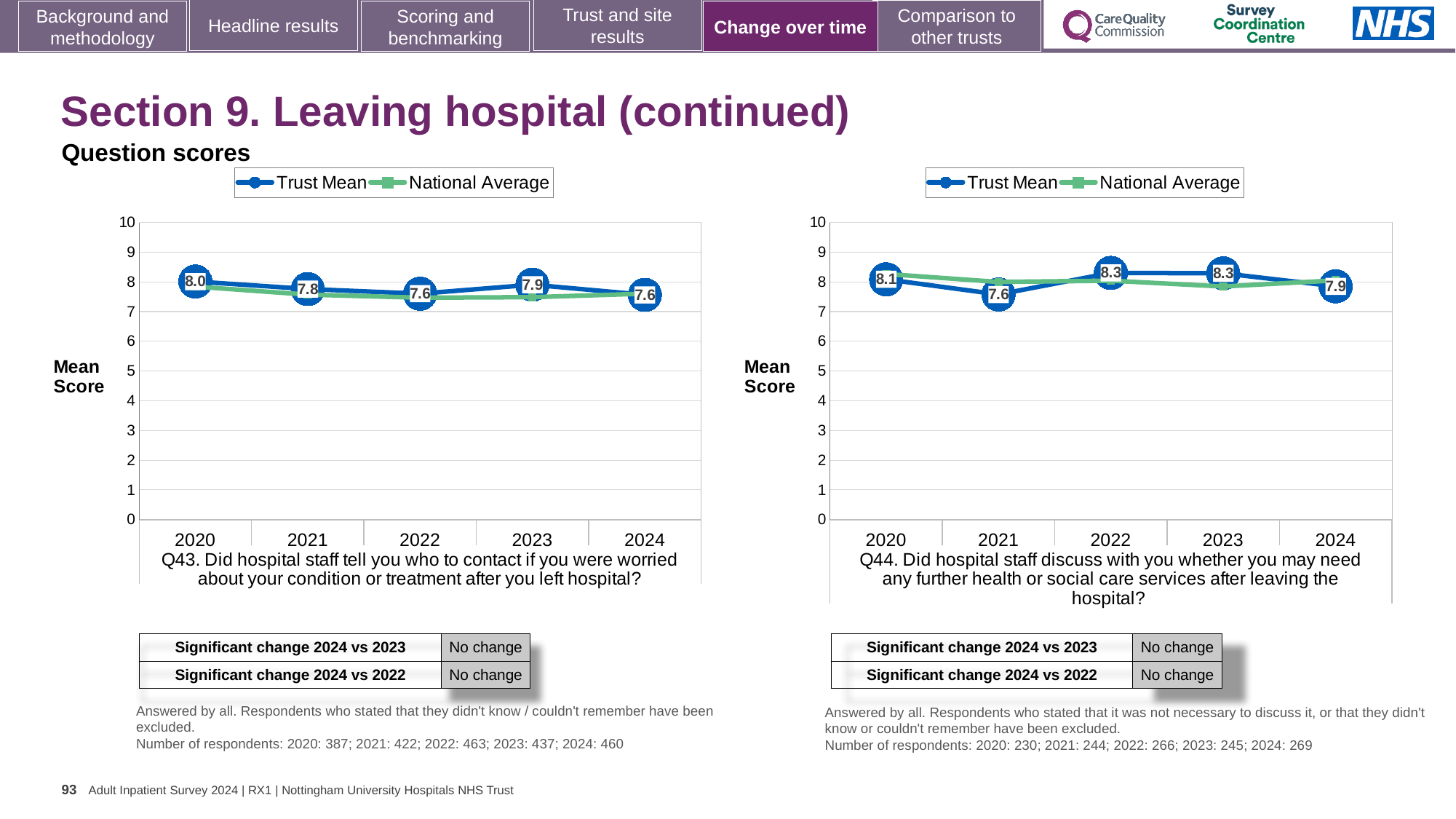
In the Q43 chart on the left, which year has the highest Trust Mean score? 2020 In the Q44 chart on the right, what is the difference between the Trust Mean scores for 2022 and 2021? 0.7 In the Q44 chart on the right, which year has the lowest Trust Mean score? 2021 In the Q44 chart on the right, what is the Trust Mean score for 2021? 7.6 What kind of chart is the Q43 chart on the left? Line chart In the Q43 chart on the left, what is the Trust Mean score for 2020? 8.0 How many series does the legend of the Q44 chart on the right list? 2 In the Q43 chart on the left, what is the difference between the Trust Mean scores for 2020 and 2024? 0.4 In the Q44 chart on the right, what is the Trust Mean score for 2024? 7.9 In the Q43 chart on the left, what is the Trust Mean score for 2023? 7.9 In the Q44 chart on the right, is the Trust Mean score higher in 2020 or in 2021? 2020 In the Q43 chart on the left, is the National Average value for 2020 greater or less than 5? greater